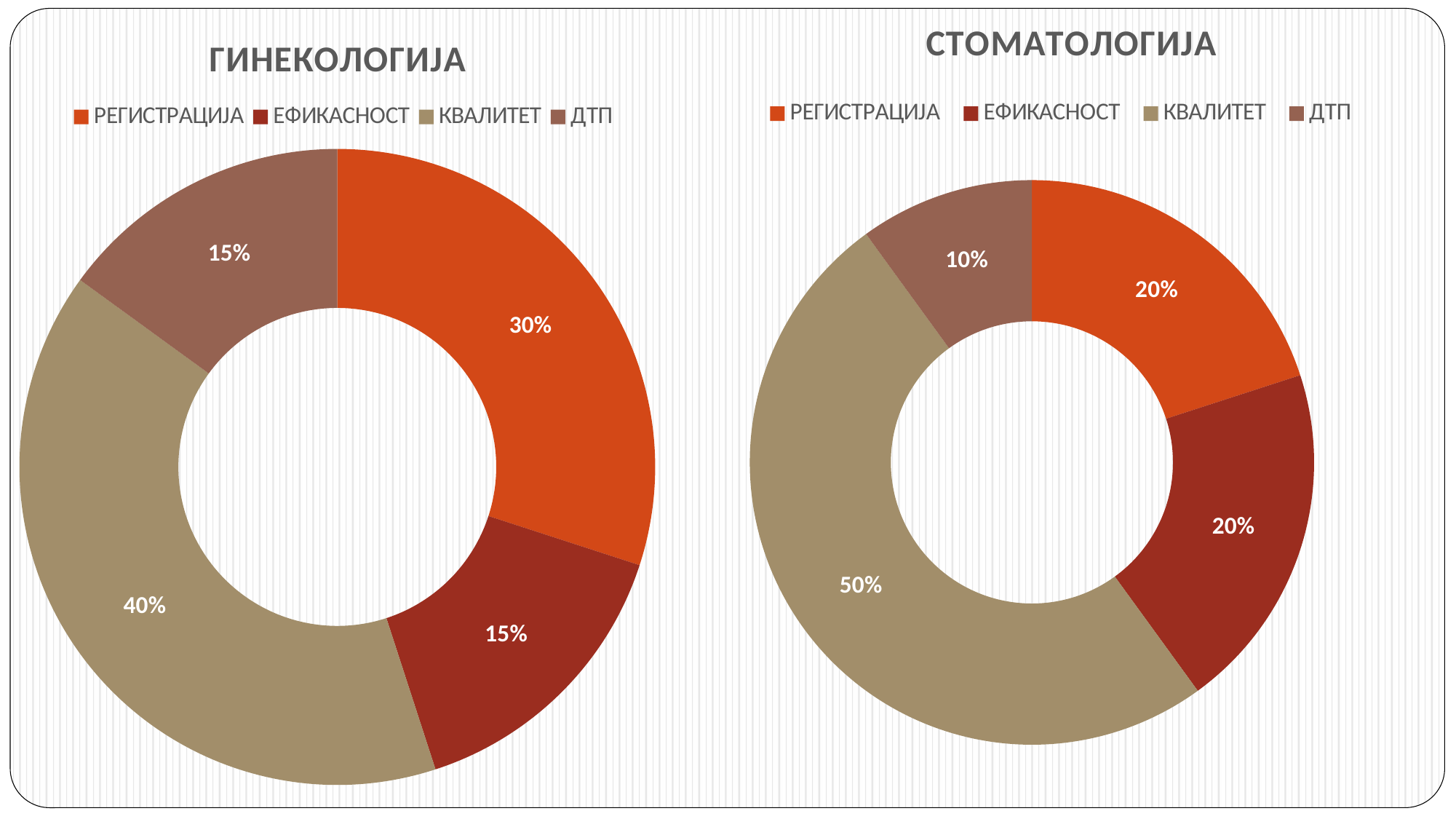
In the СТОМАТОЛОГИЈА chart, which category has the smallest share? ДТП In the СТОМАТОЛОГИЈА chart, what is the value for ДТП? 10% What is the title of the chart on the right side of the slide? СТОМАТОЛОГИЈА What type of chart is the ГИНЕКОЛОГИЈА chart? Doughnut chart Which chart has the larger value for РЕГИСТРАЦИЈА, ГИНЕКОЛОГИЈА or СТОМАТОЛОГИЈА? ГИНЕКОЛОГИЈА In the СТОМАТОЛОГИЈА chart, what is the difference between КВАЛИТЕТ and ДТП? 40% In the ГИНЕКОЛОГИЈА chart, what is the value for РЕГИСТРАЦИЈА? 30% In the СТОМАТОЛОГИЈА chart, what is the value for КВАЛИТЕТ? 50% In the ГИНЕКОЛОГИЈА chart, what is the difference between КВАЛИТЕТ and РЕГИСТРАЦИЈА? 10% In the ГИНЕКОЛОГИЈА chart, what is the value for КВАЛИТЕТ? 40% In the ГИНЕКОЛОГИЈА chart, which category has the largest share? КВАЛИТЕТ How many categories does the СТОМАТОЛОГИЈА chart show? 4